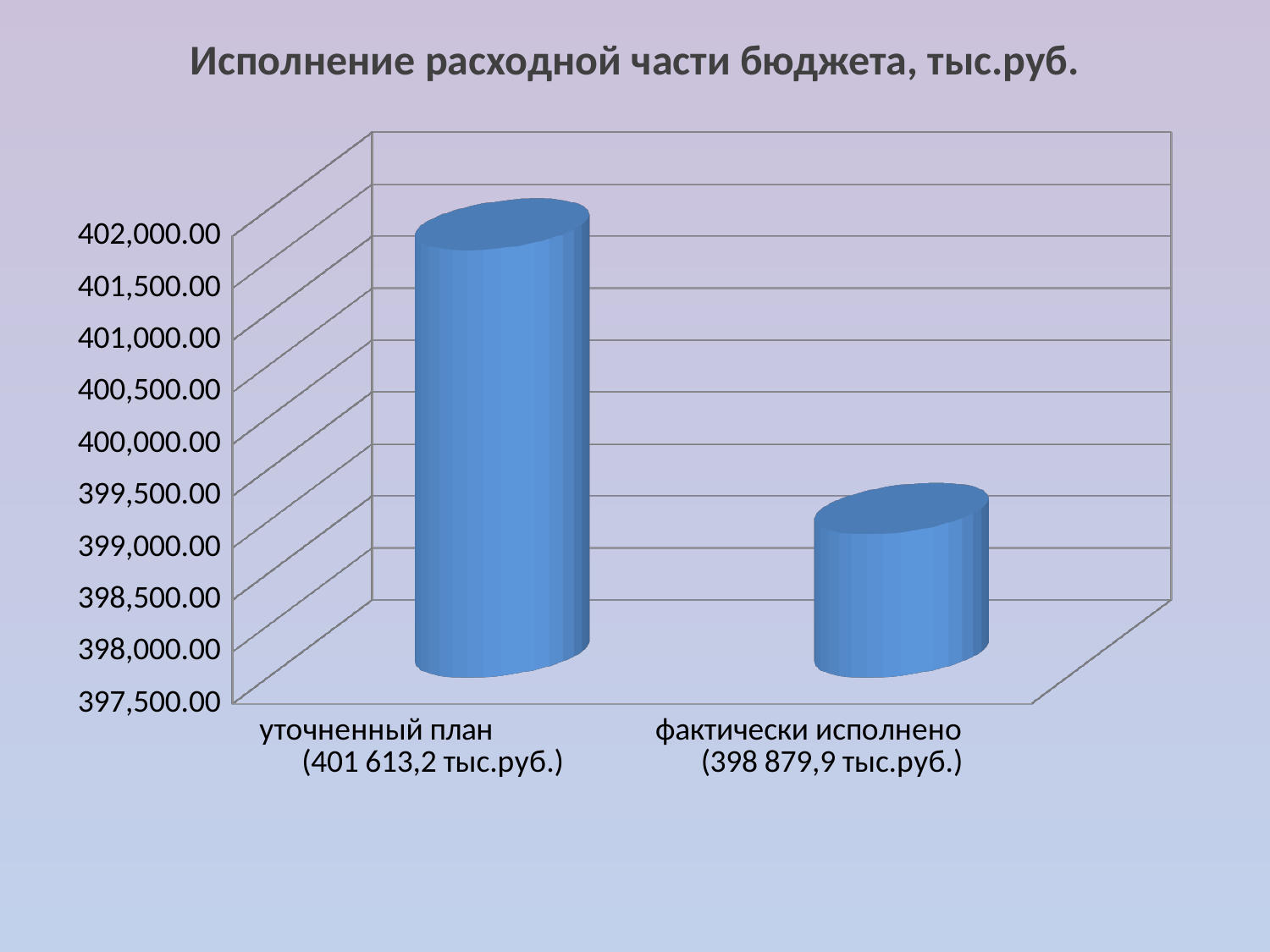
What is the value for уточненный план? 401 613,2 тыс.руб. Which category has the lowest value? фактически исполнено Which is larger, уточненный план or фактически исполнено? уточненный план What is the difference between уточненный план and фактически исполнено? 2 733,3 тыс.руб. What kind of chart is shown on the slide? bar chart Is the value for фактически исполнено greater or less than 400,000.00? less What is the value for фактически исполнено? 398 879,9 тыс.руб. Is the value for уточненный план greater or less than 401,000.00? greater What is the title of the chart? Исполнение расходной части бюджета, тыс.руб. What colour are the bars in the chart? blue How many categories are shown in the chart? 2 Which category has the highest value? уточненный план